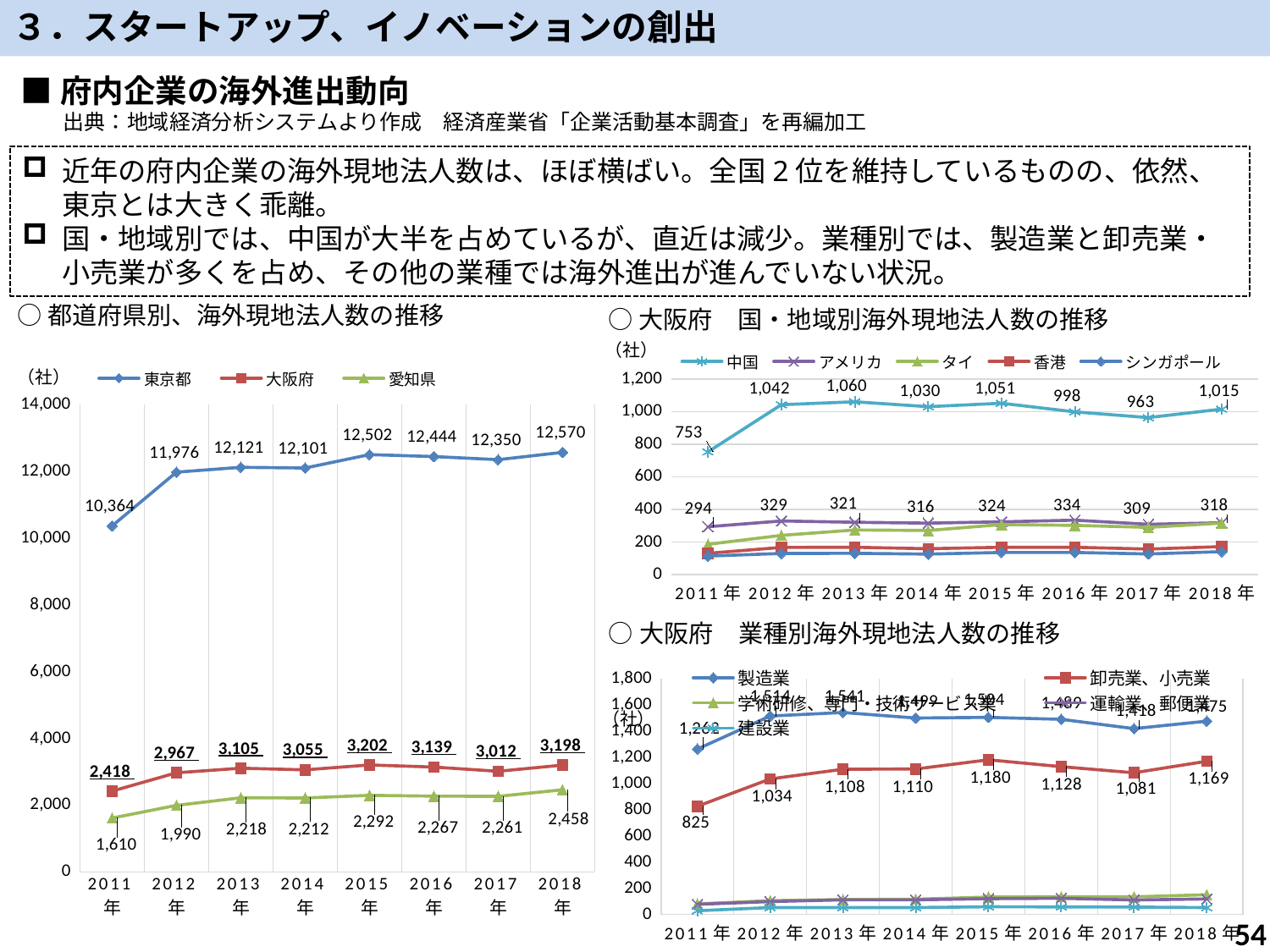
In the chart titled 大阪府 業種別海外現地法人数の推移, is the value for 卸売業、小売業 in 2011年 greater or less than 1,000? less In the chart titled 都道府県別、海外現地法人数の推移, what is the value for 東京都 in 2018年? 12,570 In the chart titled 大阪府 国・地域別海外現地法人数の推移, what is the value for 中国 in 2013年? 1,060 In the chart titled 都道府県別、海外現地法人数の推移, how many series does the legend list? 3 In the chart titled 大阪府 業種別海外現地法人数の推移, what is the value for 卸売業、小売業 in 2015年? 1,180 In the chart titled 都道府県別、海外現地法人数の推移, what is the value for 愛知県 in 2011年? 1,610 In the chart titled 大阪府 国・地域別海外現地法人数の推移, what is the value for アメリカ in 2016年? 334 In the chart titled 都道府県別、海外現地法人数の推移, in which year is the value for 東京都 lowest? 2011年 In the chart titled 都道府県別、海外現地法人数の推移, what kind of chart is it? Line chart In the chart titled 大阪府 国・地域別海外現地法人数の推移, how many series does the legend list? 5 In the chart titled 都道府県別、海外現地法人数の推移, what is the difference between 大阪府 and 愛知県 in 2018年? 740 In the chart titled 都道府県別、海外現地法人数の推移, what is the value for 大阪府 in 2015年? 3,202